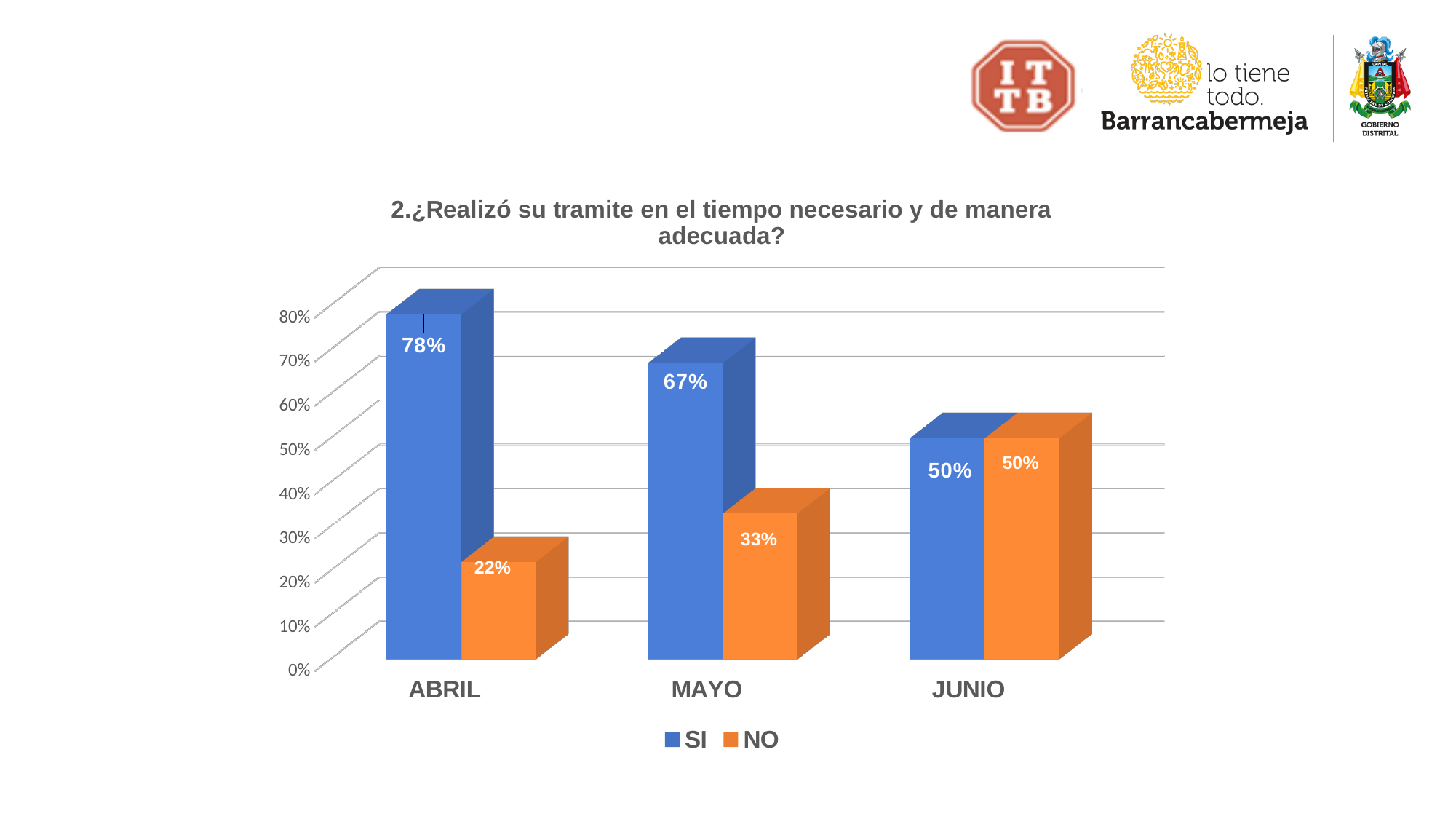
How many months are shown on the x axis? 3 How many series does the legend list? 2 What is the value for NO in MAYO? 33% Is the value for NO in MAYO greater or less than 40%? less What kind of chart is shown? bar chart Does the SI value rise or fall from ABRIL to JUNIO? fall What is the value for SI in ABRIL? 78% In which month is the SI value highest? ABRIL In which month is the NO value lowest? ABRIL What is the difference between the SI and NO values in MAYO? 34% Which is larger in ABRIL, the SI value or the NO value? SI What is the value for NO in JUNIO? 50%